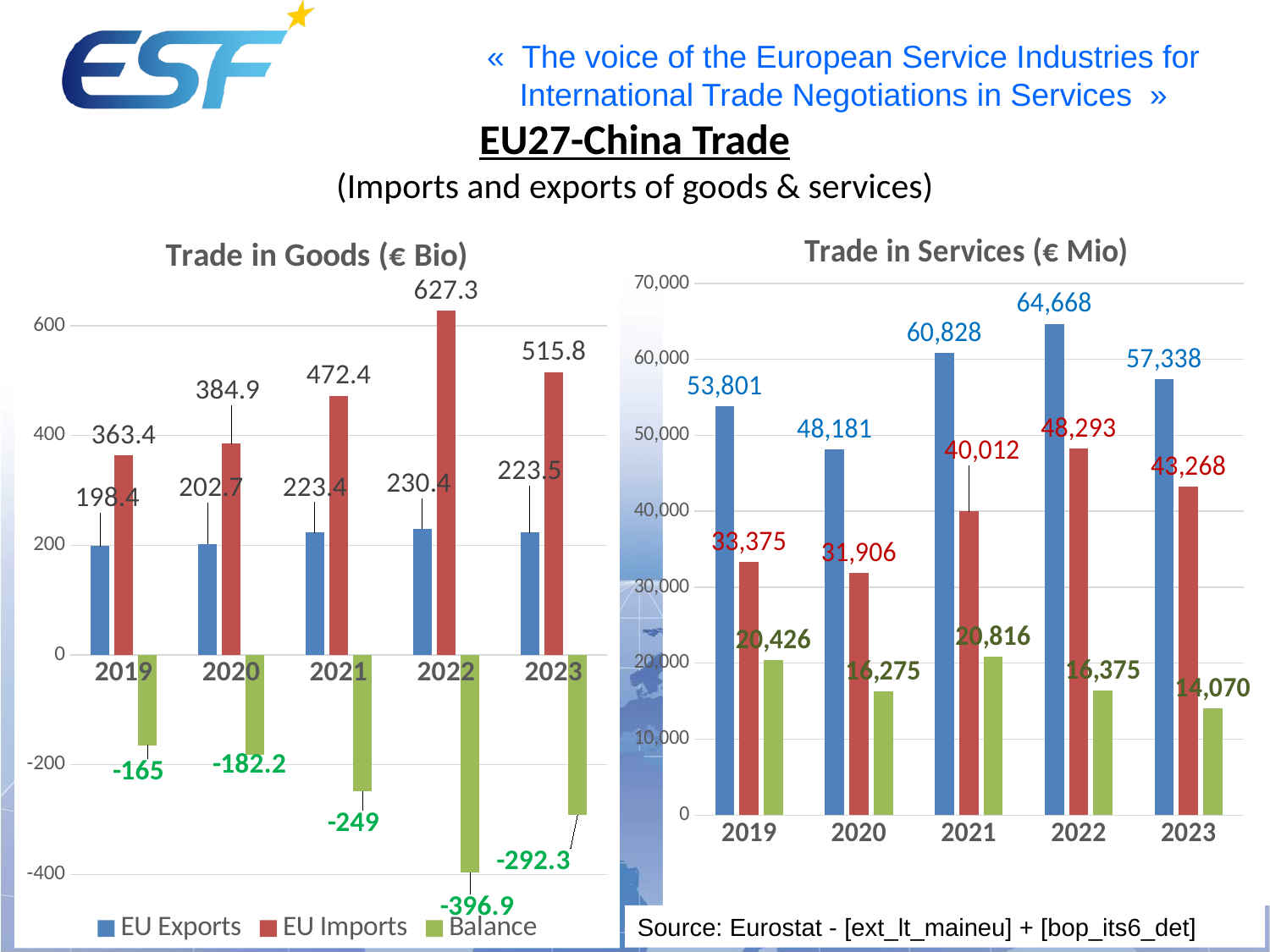
In the Trade in Services (€ Mio) chart, which year has the lowest green Balance value? 2023 In the Trade in Goods (€ Bio) chart, what is the difference between EU Imports and EU Exports in 2023? 292.3 In the Trade in Services (€ Mio) chart, what is the value of the blue EU Exports bar for 2022? 64,668 In the Trade in Goods (€ Bio) chart, what is the value of EU Imports in 2022? 627.3 How many years are shown on the x axis of the Trade in Services (€ Mio) chart? 5 How many series does the legend of the Trade in Goods (€ Bio) chart list? 3 In the Trade in Goods (€ Bio) chart, which year has the highest EU Imports value? 2022 What type of chart is the Trade in Services (€ Mio) chart? Bar chart In the Trade in Goods (€ Bio) chart, which year has the lowest EU Exports value? 2019 In the Trade in Goods (€ Bio) chart, what is the Balance value for 2021? -249 In the Trade in Services (€ Mio) chart, what is the value of the red EU Imports bar for 2020? 31,906